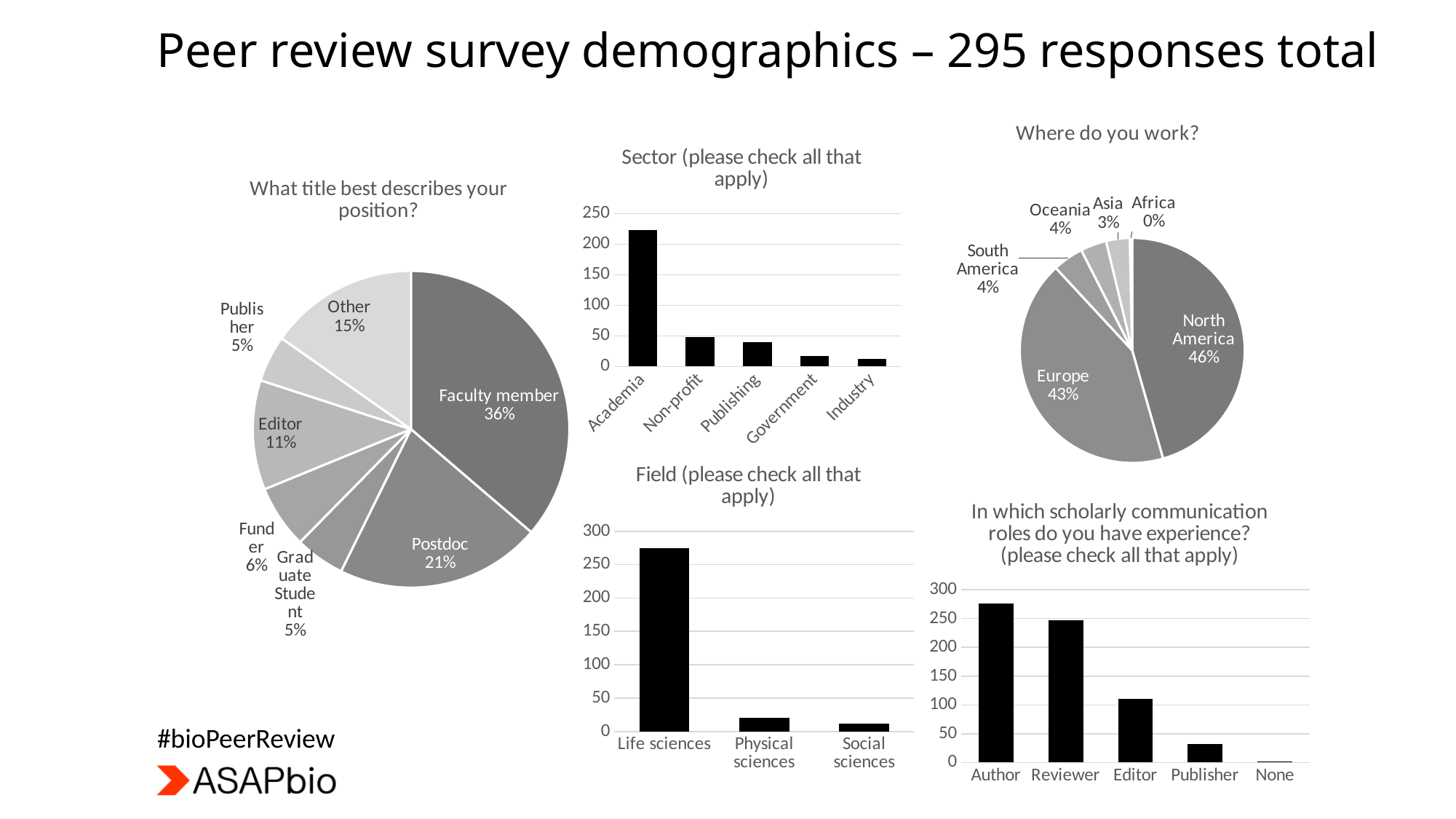
In the bar chart 'In which scholarly communication roles do you have experience?', is the value for Editor greater or less than 100? greater In the pie chart 'Where do you work?', which is larger, North America or Europe? North America What kind of chart is 'In which scholarly communication roles do you have experience?'? bar chart How many slices does the pie chart 'What title best describes your position?' have? 7 In the bar chart 'Sector (please check all that apply)', is the value for Academia greater or less than 200? greater In the pie chart 'Where do you work?', what share of respondents work in Europe? 43% In the pie chart 'What title best describes your position?', which category has the largest share? Faculty member In the bar chart 'Sector (please check all that apply)', which sector has the lowest value? Industry In the pie chart 'What title best describes your position?', what is the difference in percentage points between Postdoc and Editor? 10 How many categories are shown in the bar chart 'Field (please check all that apply)'? 3 In the pie chart 'Where do you work?', which region has the smallest share? Africa In the pie chart 'What title best describes your position?', what share of respondents are faculty members? 36%